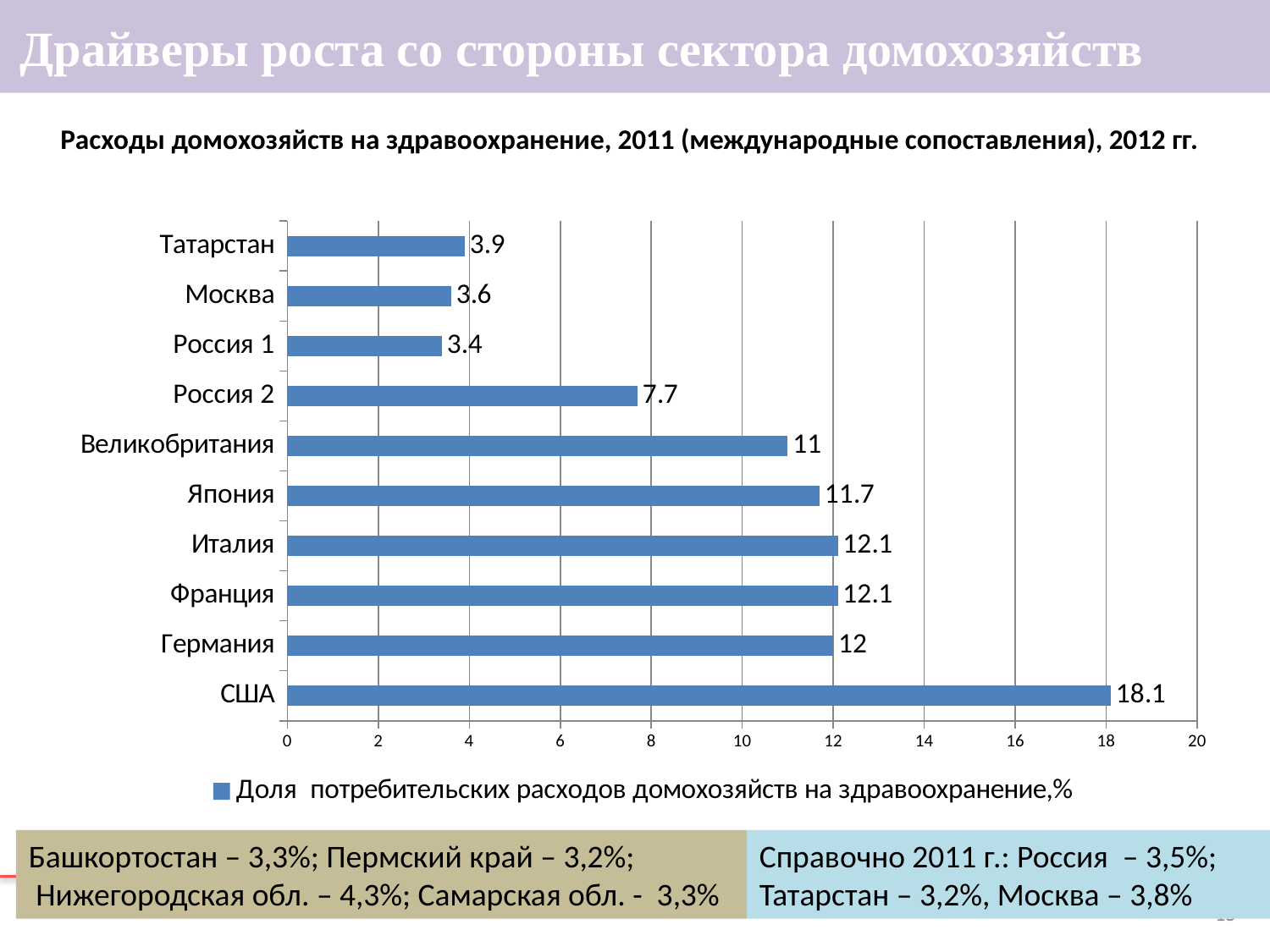
What is the value for Япония? 11.7 Which category has the lowest value? Россия 1 How many categories are shown in the chart? 10 Which category has the highest value? США What kind of chart is shown on the slide? bar chart What is the difference between the values for США and Германия? 6.1 What is the value for Россия 2? 7.7 How many series does the legend list? 1 Which is larger, the value for Япония or the value for Великобритания? Япония What is the difference between the values for Татарстан and Москва? 0.3 Is the value for Россия 2 greater or less than 8? less What is the value for США? 18.1